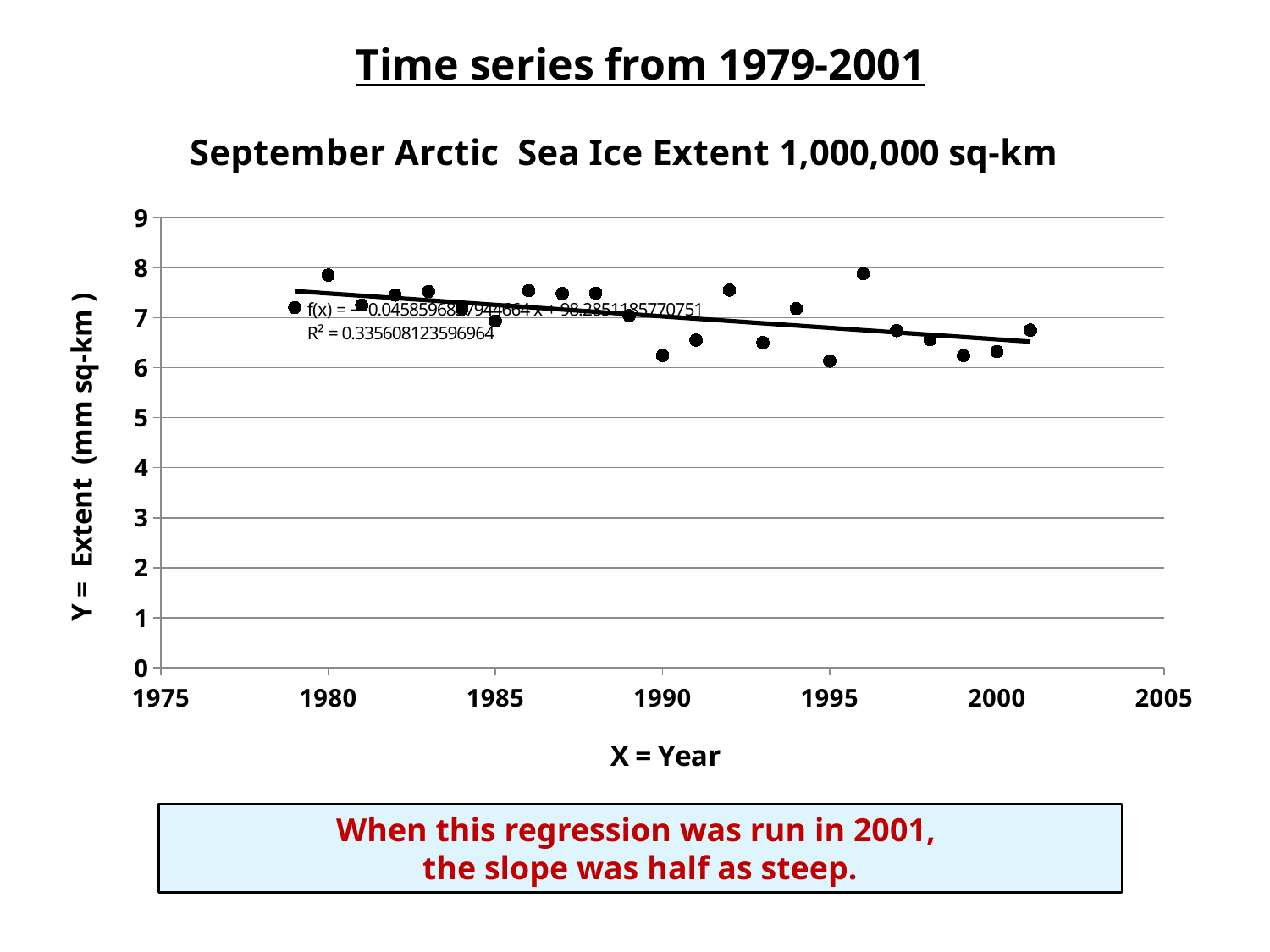
Which year has the larger value, 1980 or 1990? 1980 What kind of chart is shown on the slide? scatter chart What is the label of the x axis? X = Year How many data points are plotted on the chart? 23 Is the value for 1980 greater or less than 7? greater Is the value for 2001 greater or less than 8? less What is the title of the chart? September Arctic Sea Ice Extent 1,000,000 sq-km Which year has the larger value, 1995 or 1996? 1996 Is the value for 1996 greater or less than 7? greater Do the plotted values generally rise or fall as the year increases? fall